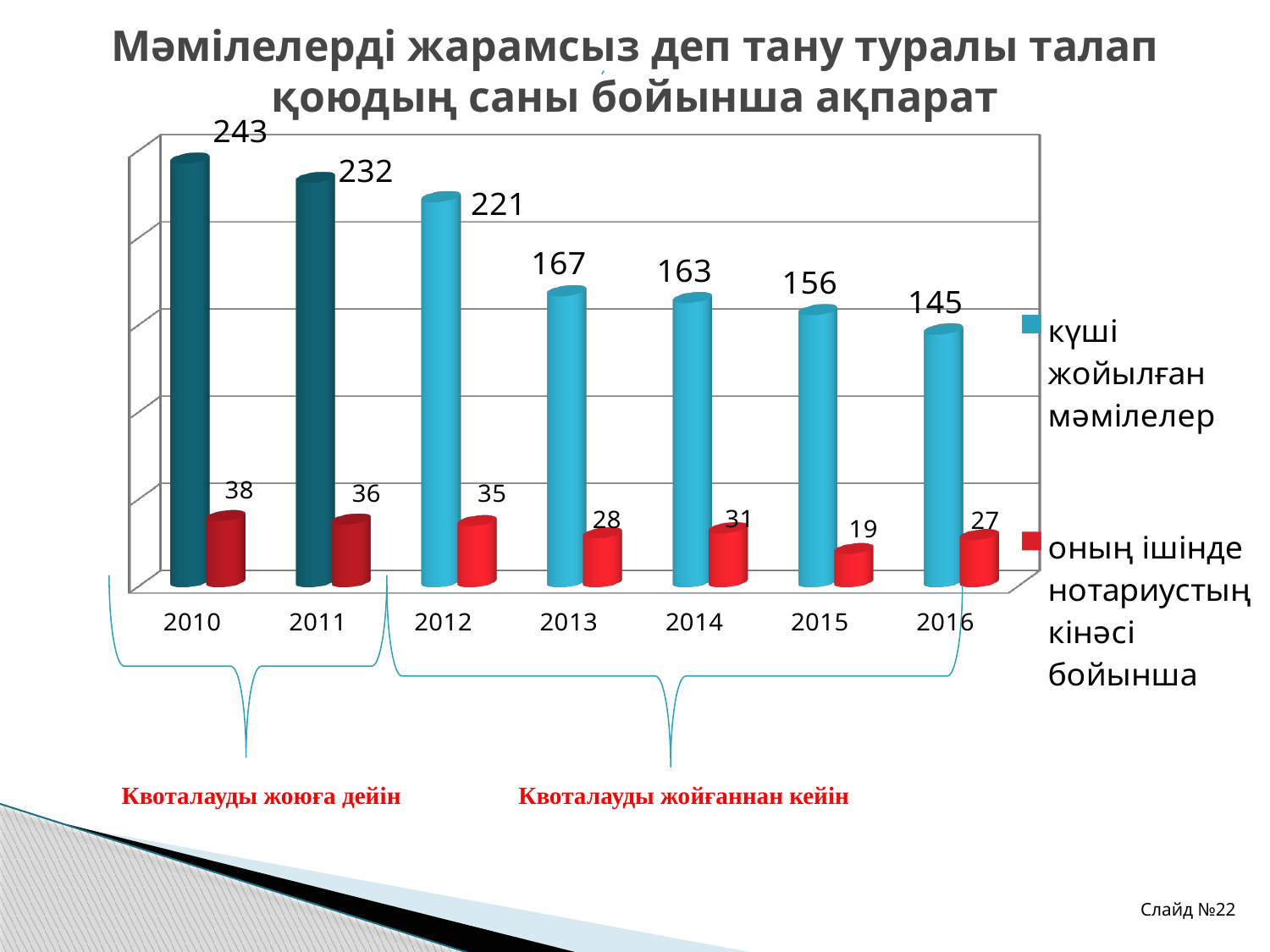
Which is larger: the "оның ішінде нотариустың кінәсі бойынша" value for 2014 or for 2016? 2014 What is the difference between the "күші жойылған мәмілелер" values for 2012 and 2013? 54 In which year is the value for "оның ішінде нотариустың кінәсі бойынша" the lowest? 2015 What kind of chart is shown on the slide? Bar chart How many years are shown on the x axis? 7 In which year is the value for "күші жойылған мәмілелер" the highest? 2010 What is the value for "күші жойылған мәмілелер" in 2010? 243 What is the value for "күші жойылған мәмілелер" in 2016? 145 Do the values for "күші жойылған мәмілелер" rise or fall from 2010 to 2016? Fall What colour are the bars for "оның ішінде нотариустың кінәсі бойынша"? Red What is the value for "оның ішінде нотариустың кінәсі бойынша" in 2015? 19 How many series does the legend list? 2